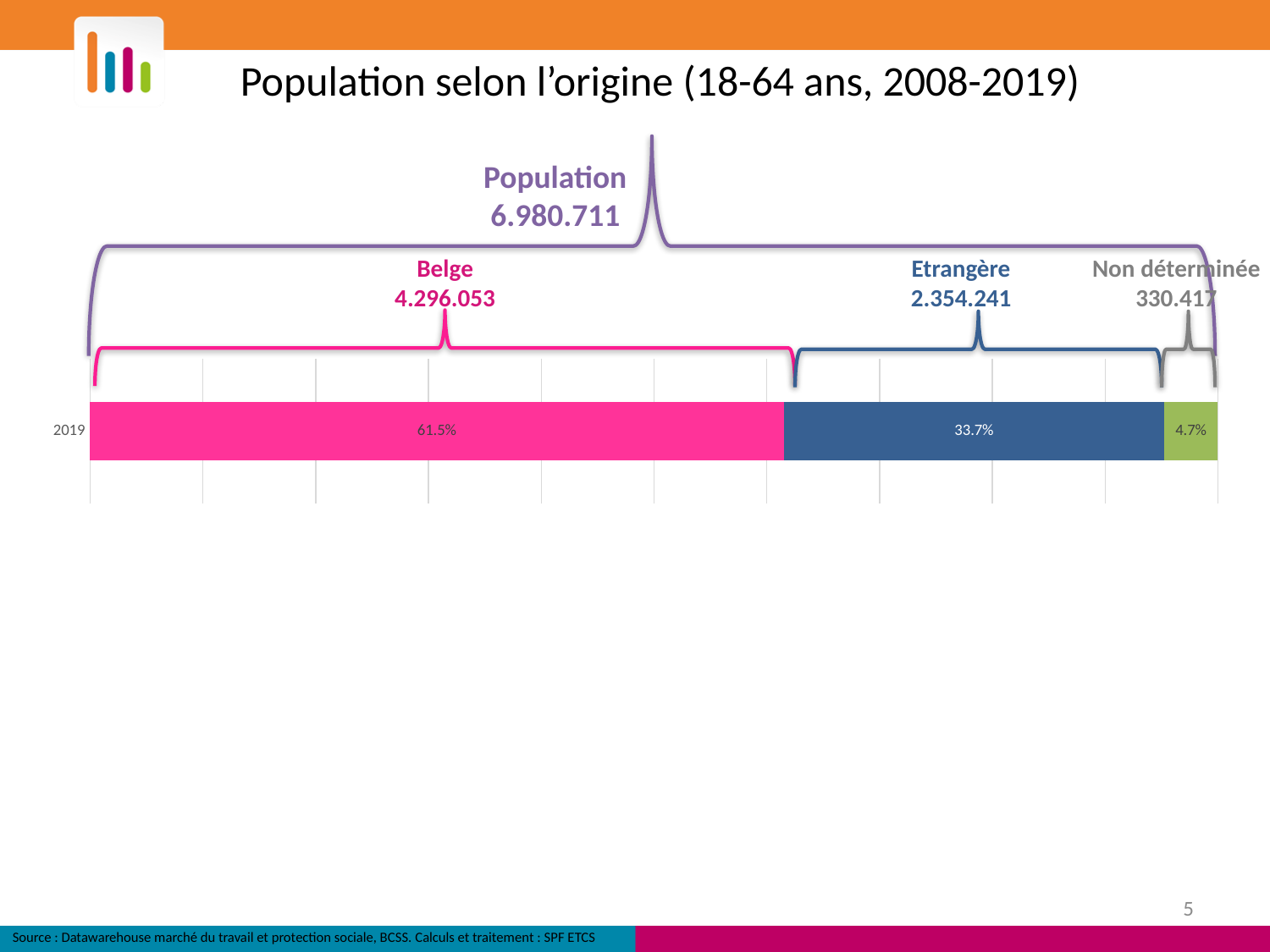
What is the difference in percentage points between the Belge share and the Etrangère share in 2019? 27.8 percentage points What percentage of the 2019 population has an undetermined origin (Non déterminée)? 4.7% What percentage of the 2019 population is of foreign origin (Etrangère)? 33.7% What is the total population figure shown above the chart? 6.980.711 What kind of chart is shown on the slide? Stacked bar chart Which year is shown on the bar's axis label? 2019 Which origin category has the smallest share of the 2019 bar? Non déterminée Which origin category has the largest share of the 2019 bar? Belge How many people of Belgian origin (Belge) are indicated above the chart? 4.296.053 How many origin categories make up the 2019 bar? 3 What percentage of the 2019 population is of Belgian origin (Belge)? 61.5% Which share is larger in 2019, Etrangère or Non déterminée? Etrangère